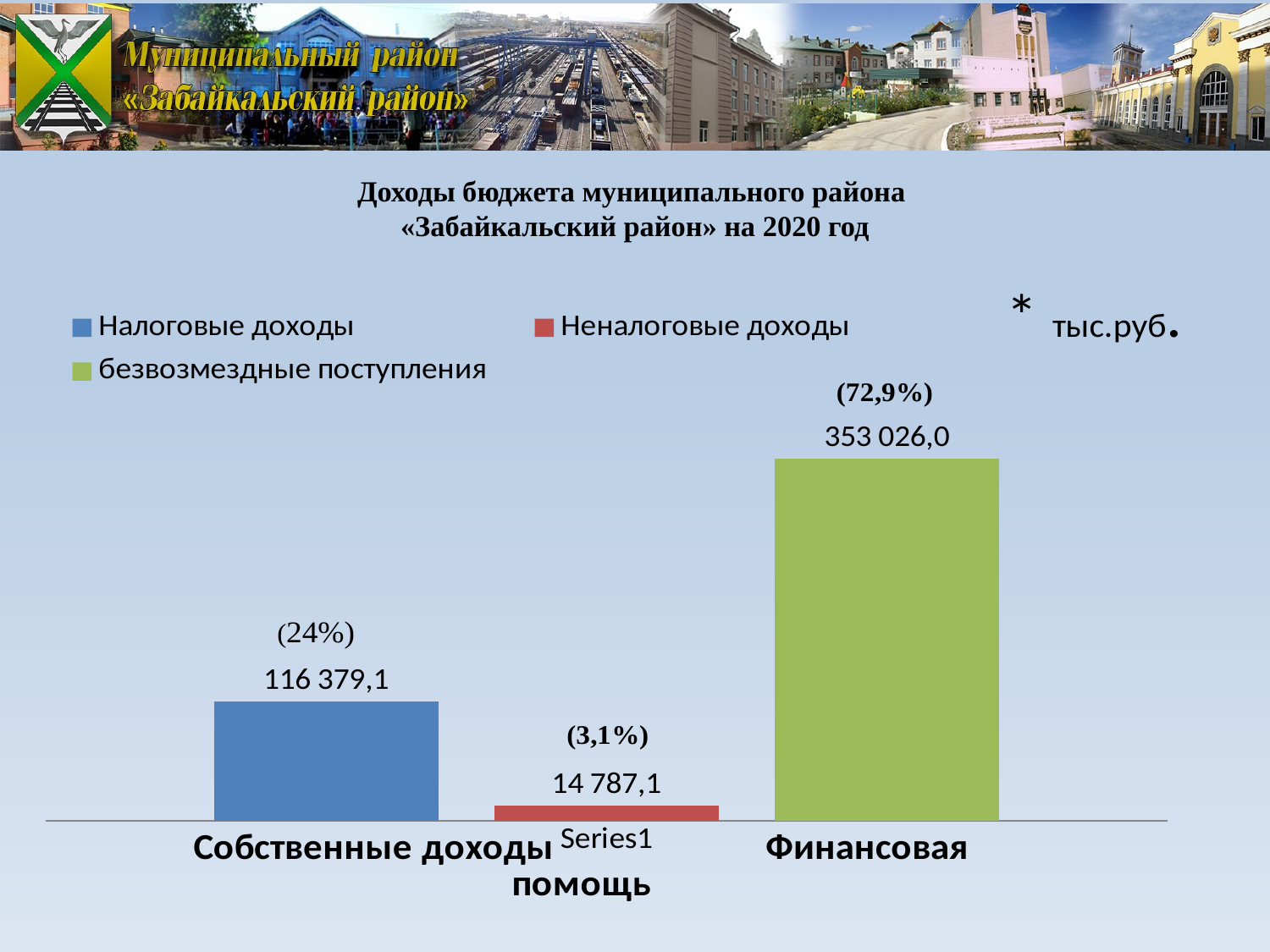
Which series has the lowest value? Неналоговые доходы How many series does the legend list? 3 What is the difference between безвозмездные поступления and Налоговые доходы? 236 646,9 What is the value for Налоговые доходы? 116 379,1 What is the value for безвозмездные поступления? 353 026,0 What percentage share is shown above the bar for Неналоговые доходы? (3,1%) Which series has the highest value? безвозмездные поступления What unit of measurement is indicated on the chart? тыс.руб. What type of chart is shown on the slide? bar chart What is the value for Неналоговые доходы? 14 787,1 What percentage share is shown above the bar for безвозмездные поступления? (72,9%) Which is larger, Налоговые доходы or Неналоговые доходы? Налоговые доходы